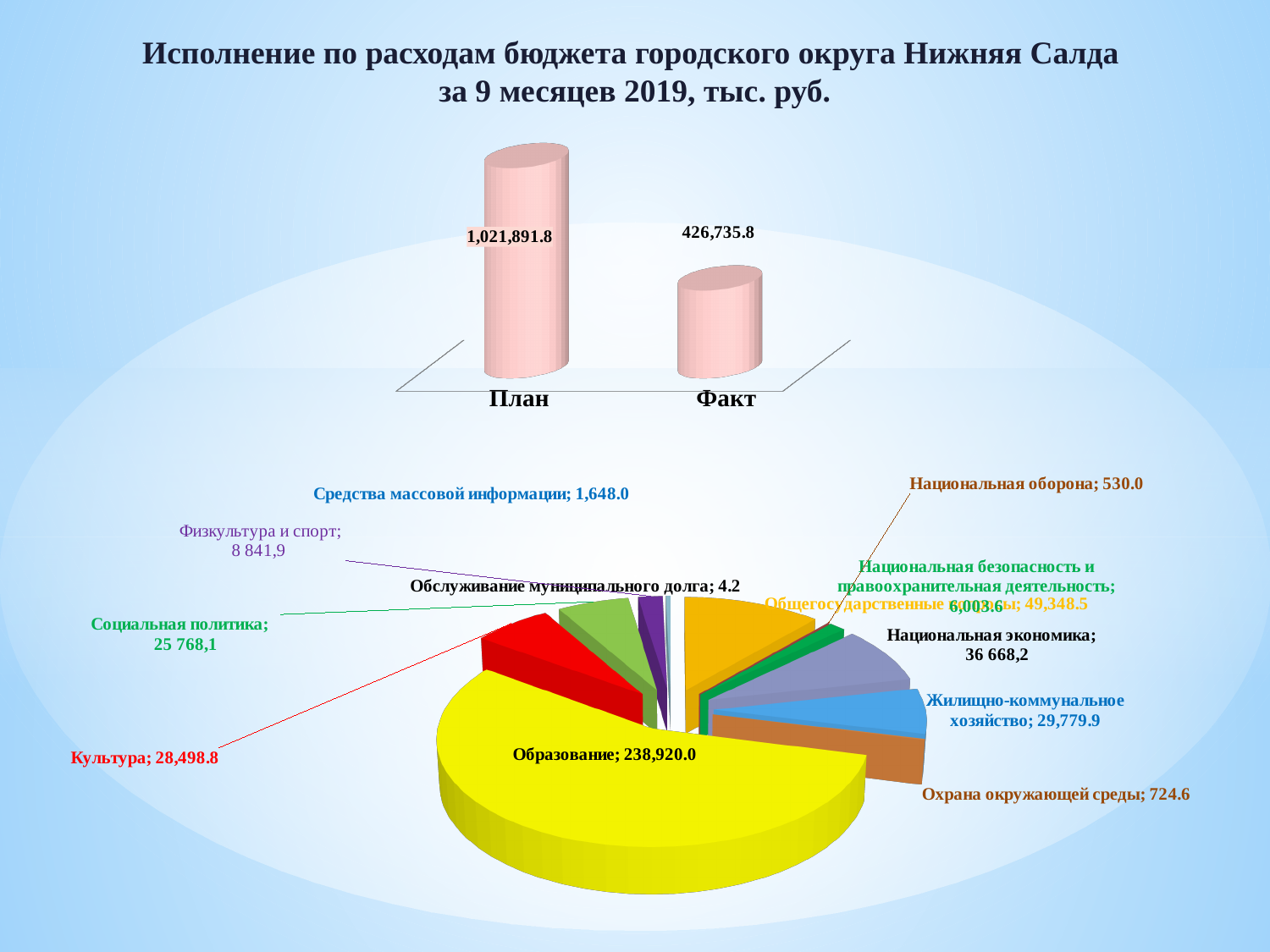
What kind of chart is the lower chart on the slide? Pie chart In the pie chart, what is the value for Образование? 238,920.0 In the pie chart, which category has the largest slice? Образование In the bar chart at the top, what is the value for Факт? 426,735.8 In the pie chart, which is larger, Культура or Социальная политика? Культура In the pie chart, which category has the smallest value? Обслуживание муниципального долга In the bar chart at the top, which category is higher, План or Факт? План In the bar chart at the top, what is the value for План? 1,021,891.8 In the pie chart, what is the value for Жилищно-коммунальное хозяйство? 29,779.9 In the bar chart at the top, what is the difference between План and Факт? 595,156.0 In the bar chart at the top, how many categories are shown? 2 In the pie chart, what is the value for Обслуживание муниципального долга? 4.2